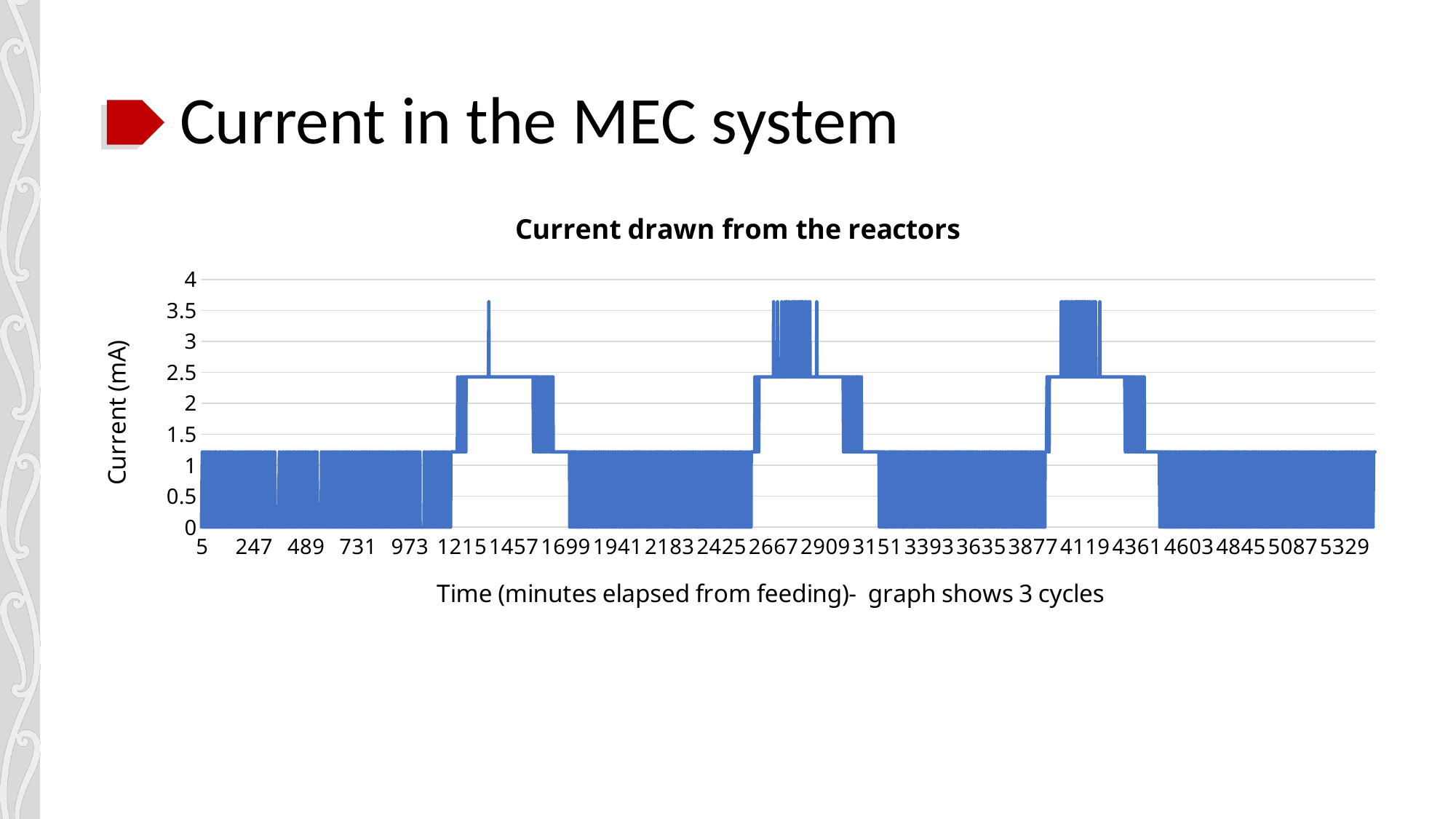
What is the title of the chart? Current drawn from the reactors What is the first tick value shown on the horizontal axis? 5 Is the plateau current between about 1215 and 1699 minutes greater or less than 2? greater Is the peak current reached around 4119 minutes greater or less than 3? greater What is the label of the vertical axis? Current (mA) What is the highest value shown on the vertical axis? 4 According to the x-axis label, how many cycles does the graph show? 3 Is the peak current reached around 2909 minutes greater or less than 3.5? greater What kind of chart is shown on the slide? line chart What is the last tick value shown on the horizontal axis? 5329